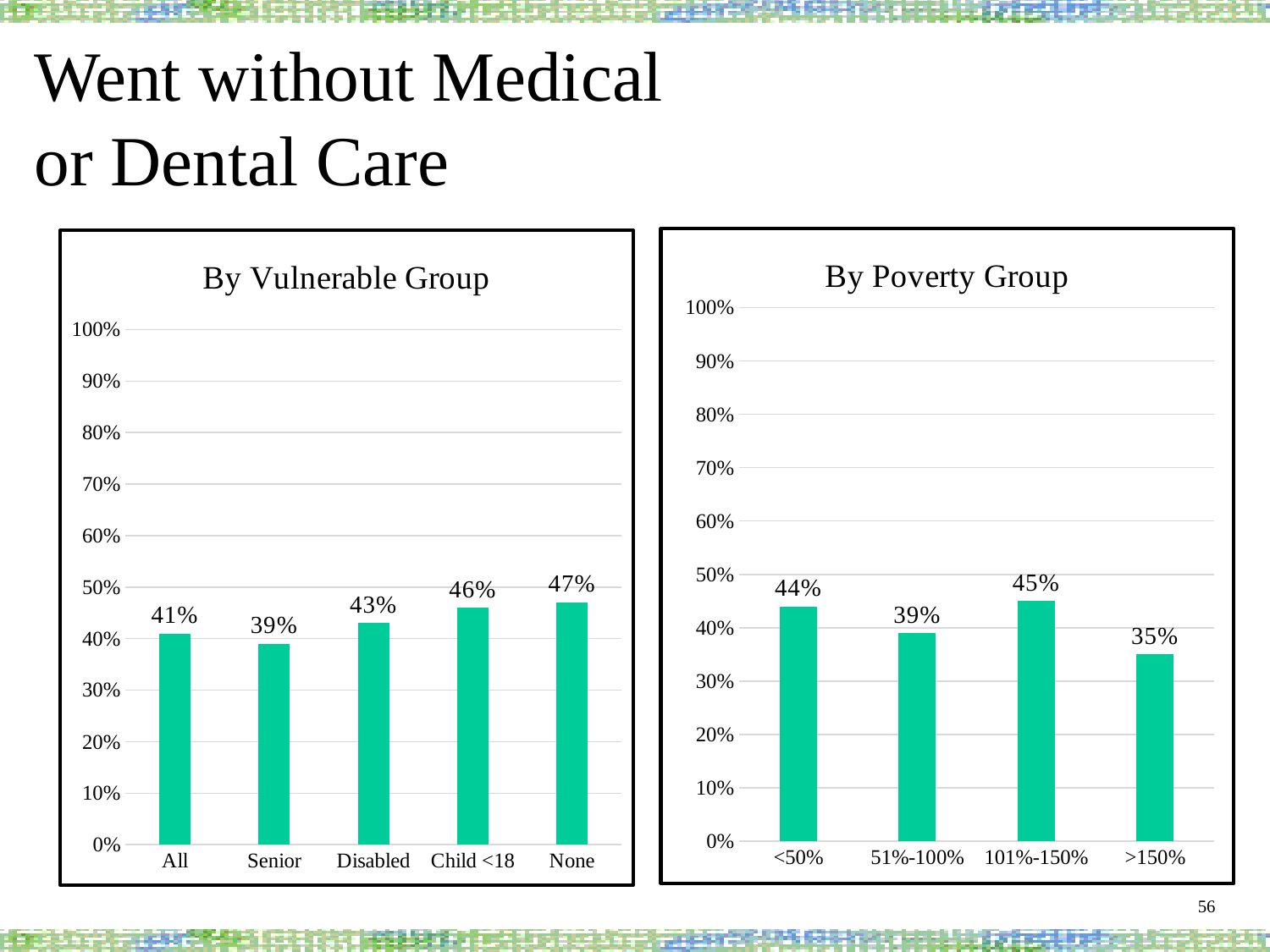
In the 'By Poverty Group' chart, what is the value for 101%-150%? 45% In the 'By Vulnerable Group' chart, how many categories are shown? 5 In the 'By Poverty Group' chart, which is larger, the value for <50% or the value for 51%-100%? <50% In the 'By Vulnerable Group' chart, what is the value for Child <18? 46% What kind of chart is the 'By Poverty Group' chart? Bar chart In the 'By Vulnerable Group' chart, which category has the highest value? None In the 'By Poverty Group' chart, which category has the lowest value? >150% In the 'By Poverty Group' chart, what is the value for >150%? 35% In the 'By Vulnerable Group' chart, what is the difference between the values for None and All? 6% In the 'By Vulnerable Group' chart, what is the value for Senior? 39% In the 'By Poverty Group' chart, what is the difference between the values for <50% and >150%? 9% In the 'By Vulnerable Group' chart, which category has the lowest value? Senior